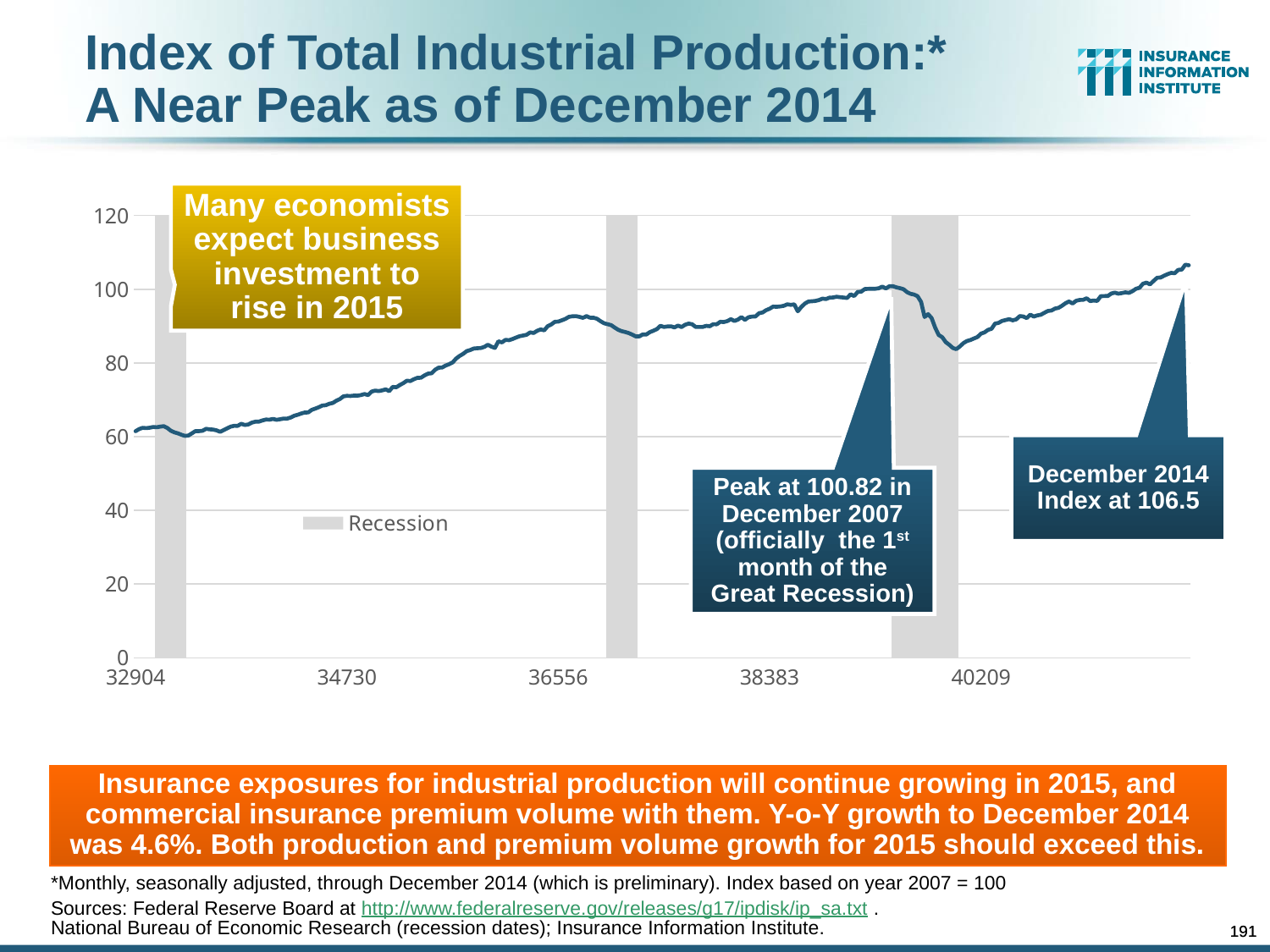
Which is higher: the index in December 2007 or in December 2014? December 2014 What was the Index of Total Industrial Production in December 2014? 106.5 How many shaded recession periods are shown on the chart? 3 Over the whole period shown, does the index generally rise or fall along the x axis? rise What does the grey shading in the chart represent, according to the legend? Recession Is the index value at the start of the series greater or less than 80? less Is the December 2014 index value greater or less than 100? greater What kind of chart is shown on the slide? line chart Is the lowest index value after the December 2007 peak greater or less than 80? greater By how much does the December 2014 index value exceed the December 2007 peak? 5.68 What is the highest value shown on the y axis? 120 What was the peak value of the index in December 2007? 100.82